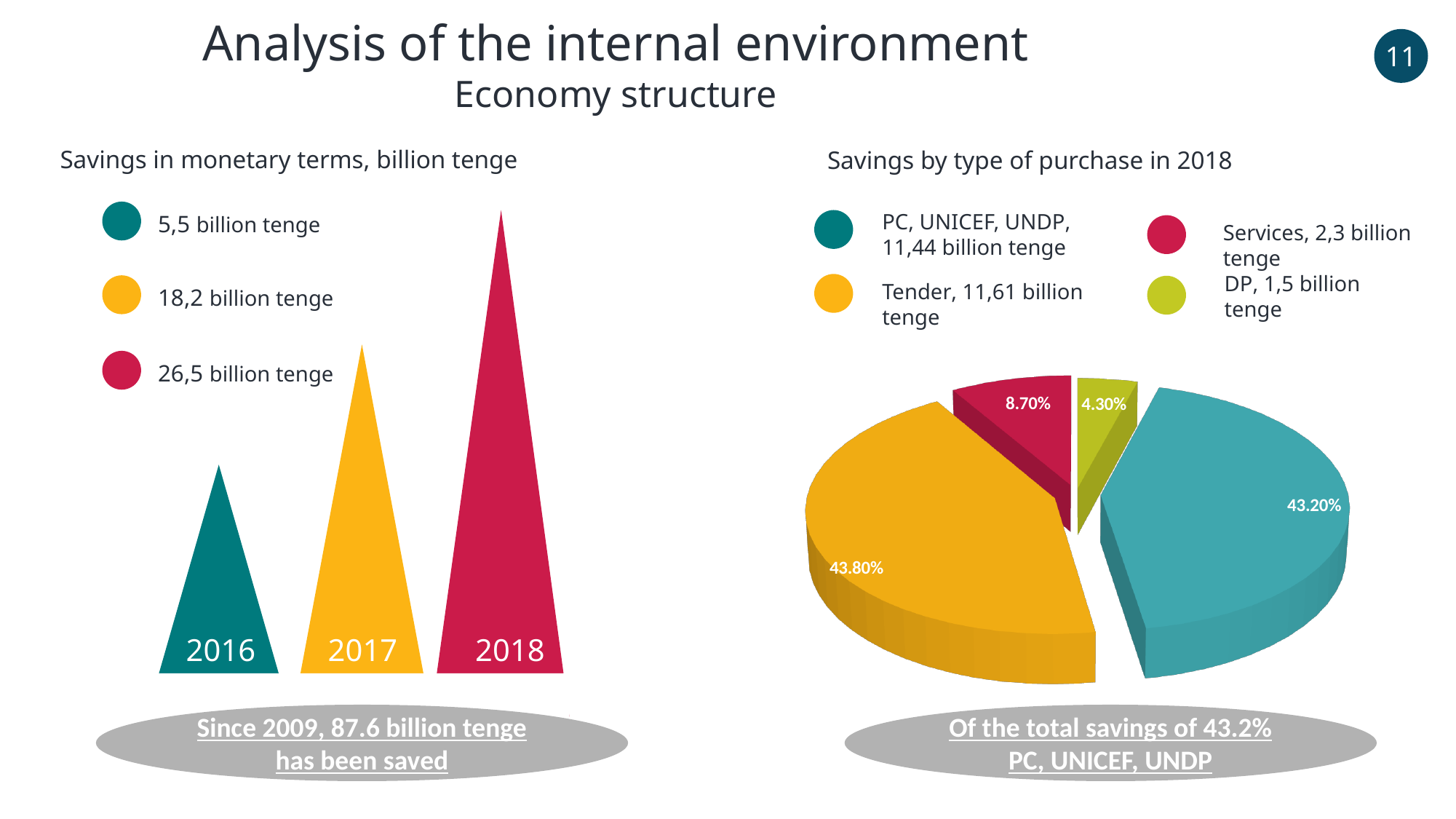
In the 'Savings by type of purchase in 2018' chart, which type of purchase has the smallest share? DP In the 'Savings in monetary terms, billion tenge' chart, what is the value for 2016? 5,5 billion tenge In the 'Savings in monetary terms, billion tenge' chart, which year has the highest savings? 2018 In the 'Savings by type of purchase in 2018' chart, what is the monetary value for PC, UNICEF, UNDP? 11,44 billion tenge In the 'Savings in monetary terms, billion tenge' chart, what is the value for 2018? 26,5 billion tenge In the 'Savings in monetary terms, billion tenge' chart, what is the difference between the 2018 and 2017 values? 8,3 billion tenge In the 'Savings by type of purchase in 2018' chart, what share does Tender have? 43.80% In the 'Savings in monetary terms, billion tenge' chart, how many years are shown? 3 In the 'Savings in monetary terms, billion tenge' chart, do savings rise or fall from 2016 to 2018? rise In the 'Savings by type of purchase in 2018' chart, what share does Services have? 8.70% What kind of chart is 'Savings by type of purchase in 2018'? pie chart In the 'Savings in monetary terms, billion tenge' chart, which year has the lowest savings? 2016